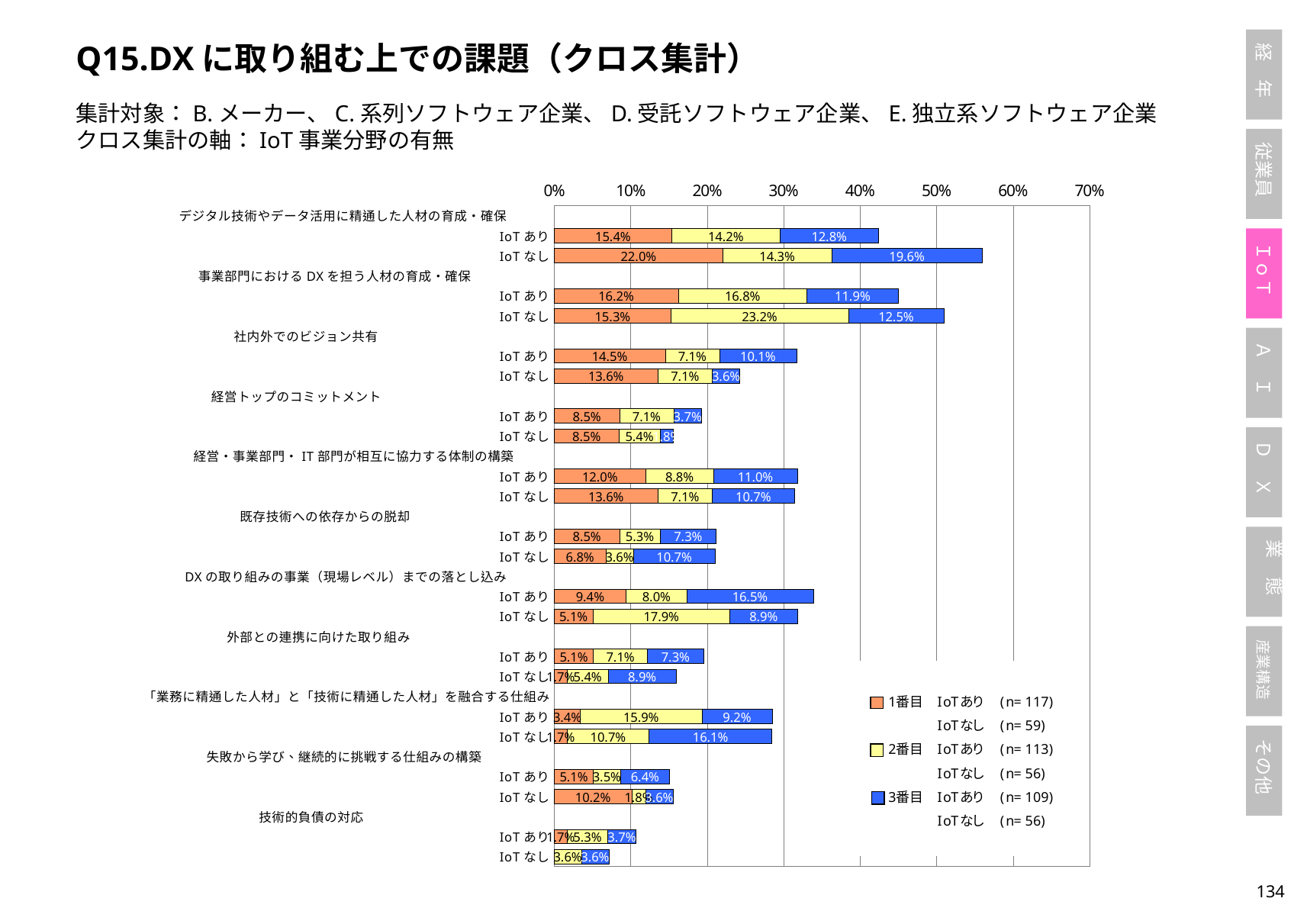
What is the 2番目 value for IoTなし in the category 事業部門におけるDXを担う人材の育成・確保? 23.2% How many series does the legend list? 3 What is the total of the stacked bar for IoTなし in the category デジタル技術やデータ活用に精通した人材の育成・確保? 55.9% Which is larger: the 3番目 value for IoTあり or for IoTなし in the category 社内外でのビジョン共有? IoTあり What is the 1番目 value for IoTなし in the category デジタル技術やデータ活用に精通した人材の育成・確保? 22.0% What is the 2番目 value for IoTあり in the category 「業務に精通した人材」と「技術に精通した人材」を融合する仕組み? 15.9% What is the total of the stacked bar for IoTあり in the category デジタル技術やデータ活用に精通した人材の育成・確保? 42.4% What type of chart is shown on the slide? stacked bar chart What is the difference between the 1番目 values for IoTなし and IoTあり in the category デジタル技術やデータ活用に精通した人材の育成・確保? 6.6% What is the 3番目 value for IoTあり in the category DXの取り組みの事業（現場レベル）までの落とし込み? 16.5% Is the total bar for IoTなし in the category デジタル技術やデータ活用に精通した人材の育成・確保 greater or less than 50%? greater According to the legend, what is the n for IoTあり in the 1番目 series? 117